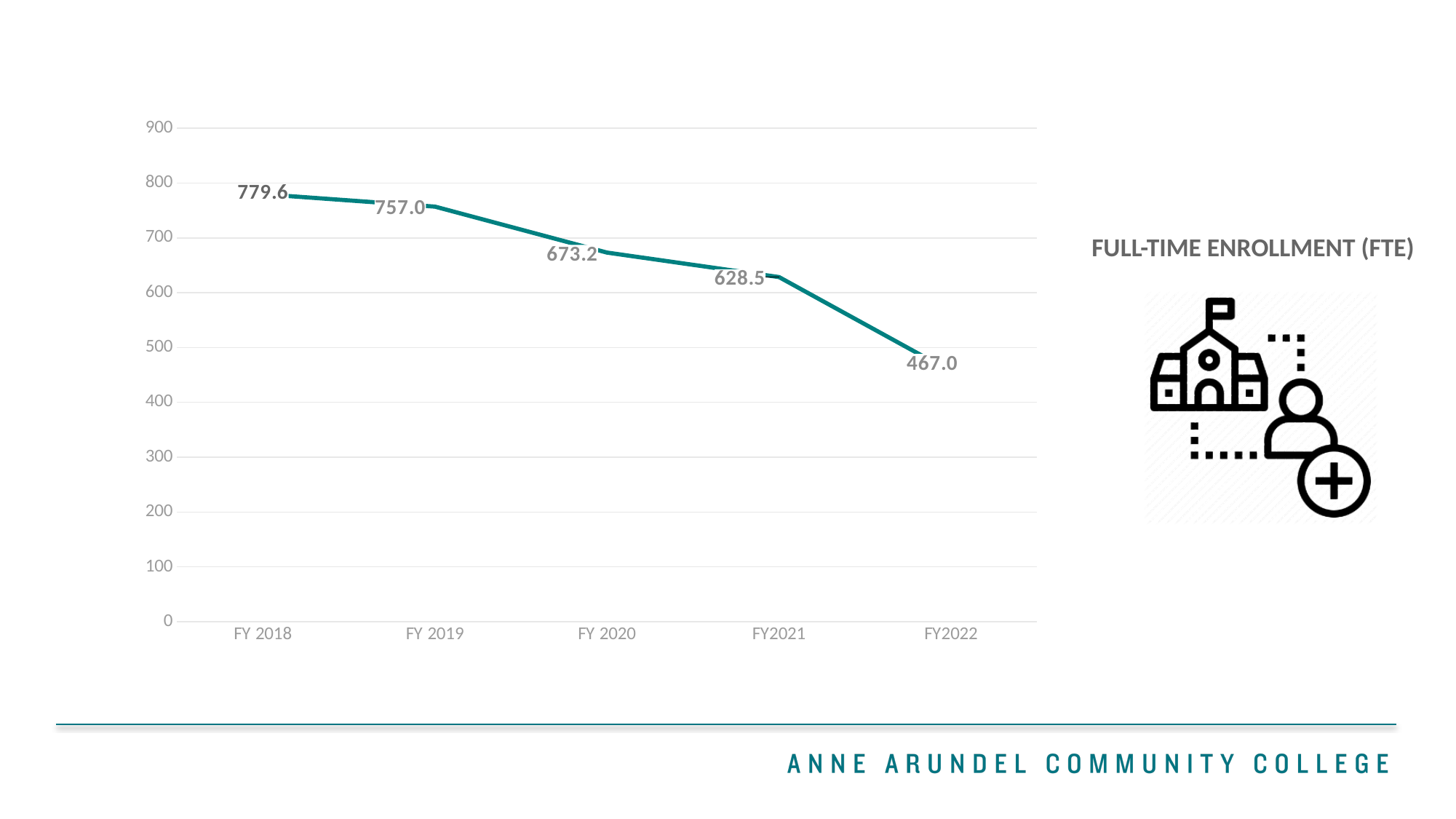
What is the value for FY2022? 467.0 Which is larger, the value for FY 2019 or the value for FY2021? FY 2019 What is the value for FY 2020? 673.2 What is the value for FY 2018? 779.6 Which fiscal year has the highest value? FY 2018 What is the difference between the FY 2018 value and the FY2022 value? 312.6 How many fiscal years are plotted on the chart? 5 Is the value for FY2021 greater or less than 600? greater Do the values rise or fall from FY 2018 to FY2022? fall What is the difference between the FY 2019 value and the FY 2020 value? 83.8 What kind of chart is shown on the slide? line chart Which fiscal year has the lowest value? FY2022